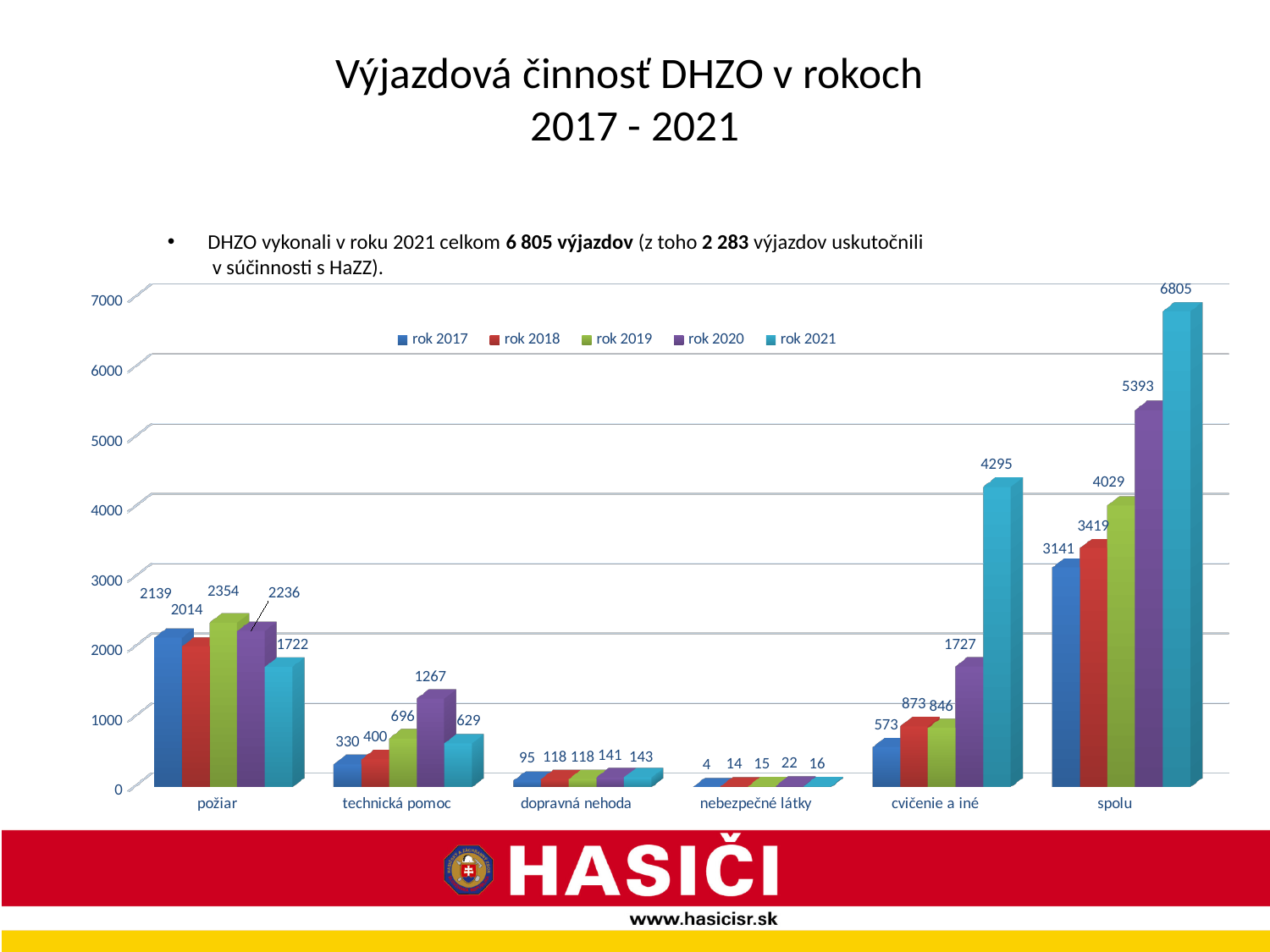
What is the value for rok 2021 in the spolu category? 6805 What is the value for rok 2020 in the technická pomoc category? 1267 What is the value for rok 2021 in the cvičenie a iné category? 4295 Which year has the lowest value in the nebezpečné látky category? rok 2017 Which is larger in the cvičenie a iné category: rok 2018 or rok 2019? rok 2018 How many categories are shown on the x axis? 6 What kind of chart is shown on the slide? bar chart What is the difference between the rok 2021 and rok 2020 values in the spolu category? 1412 How many series does the legend list? 5 Which year has the highest value in the požiar category? rok 2019 Do the values in the spolu category rise or fall from rok 2017 to rok 2021? rise What is the value for rok 2017 in the požiar category? 2139